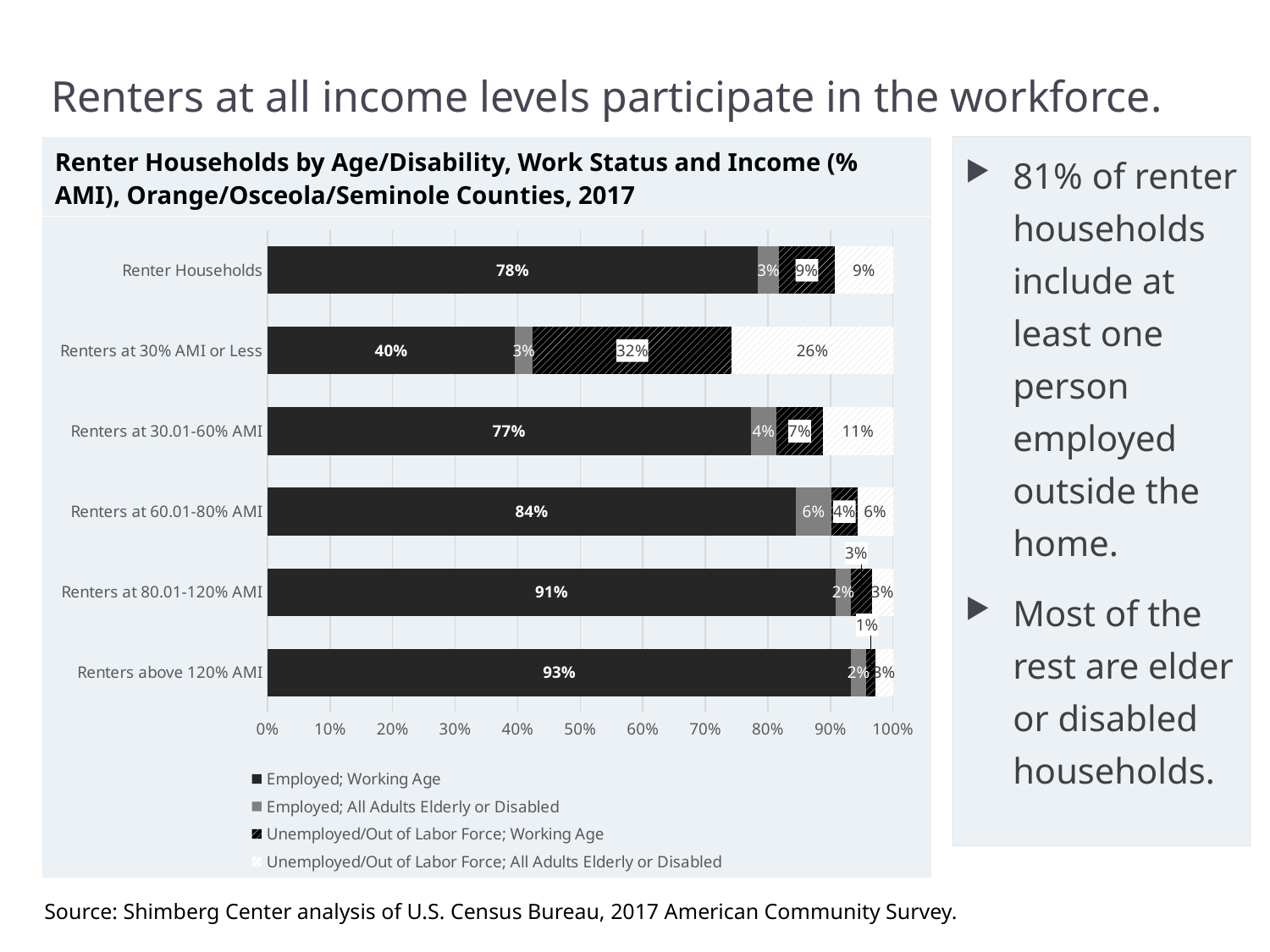
How many series does the legend list? 4 What is the title of the chart? Renter Households by Age/Disability, Work Status and Income (% AMI), Orange/Osceola/Seminole Counties, 2017 Which category has the lowest Employed; Working Age value? Renters at 30% AMI or Less What is the Unemployed/Out of Labor Force; Working Age value for Renters at 30% AMI or Less? 32% What is the Employed; Working Age value for Renter Households? 78% What type of chart is shown on the slide? Stacked bar chart How many categories are plotted on the chart? 6 What is the difference between the Employed; Working Age values for Renters at 60.01-80% AMI and Renters at 30.01-60% AMI? 7% What is the Unemployed/Out of Labor Force; All Adults Elderly or Disabled value for Renters at 30.01-60% AMI? 11% What is the Employed; Working Age value for Renters at 30% AMI or Less? 40% Which is larger: the Employed; All Adults Elderly or Disabled value for Renters at 60.01-80% AMI or for Renters at 30.01-60% AMI? Renters at 60.01-80% AMI Which category has the highest Employed; Working Age value? Renters above 120% AMI